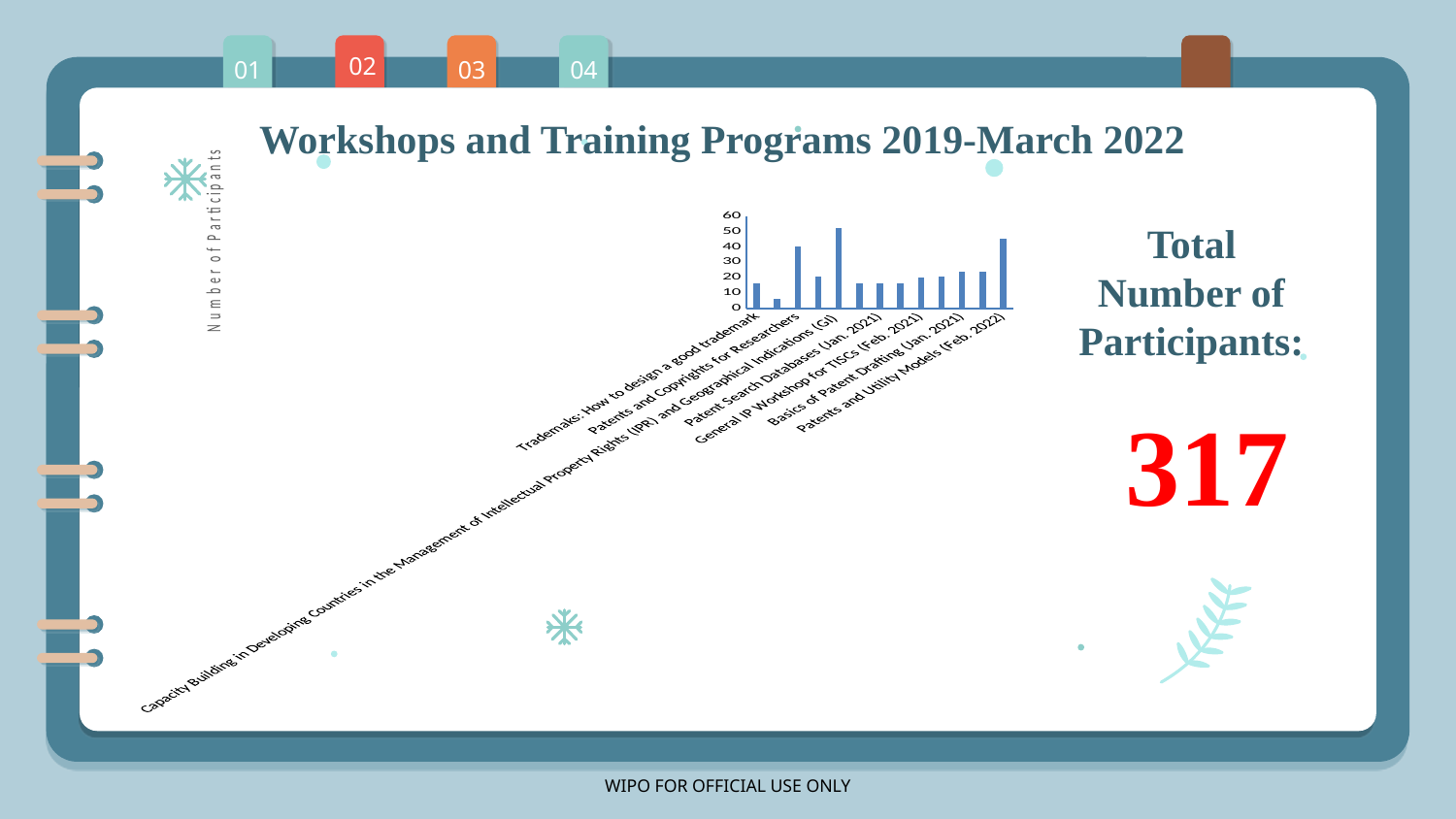
Is the value of the last bar on the right (Patents and Utility Models (Feb. 2022)) greater or less than 40? greater What total number of participants is stated on the slide next to the chart? 317 What is the highest tick value shown on the vertical axis of the chart? 60 Which bar is the tallest in the chart, counting from the left? the fifth bar Is the value of the first bar on the left greater or less than 30? less How many bars are plotted in the chart? 13 What kind of chart is shown on the slide? bar chart What is the label on the vertical axis of the chart? Number of Participants Is the value of the shortest bar in the chart greater or less than 10? less What is the title shown above the chart? Workshops and Training Programs 2019-March 2022